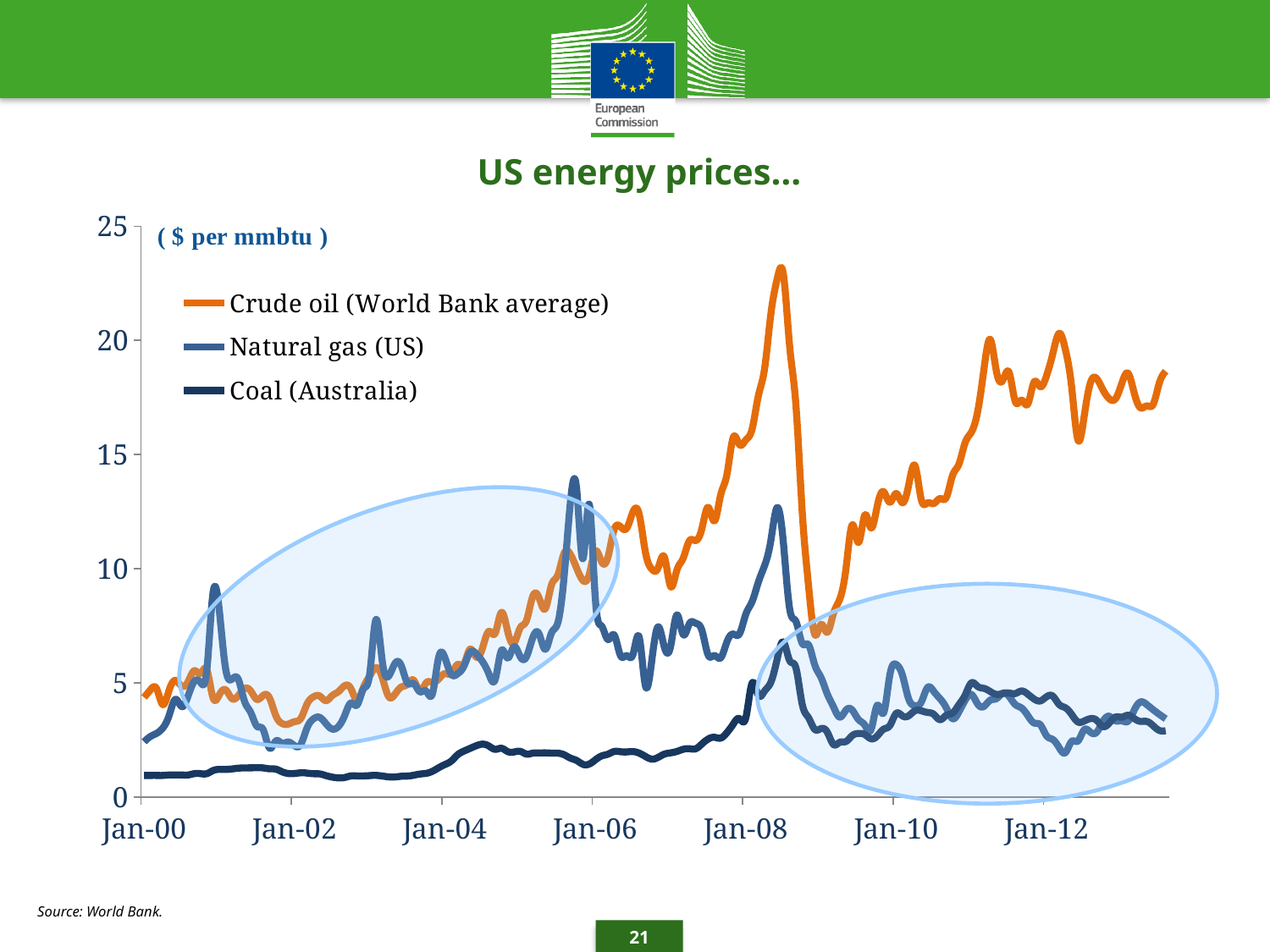
What kind of chart is shown on the slide? Line chart How many series does the legend list? 3 Is the value for Natural gas (US) at Jan-12 greater or less than 10? less Which series has the lowest value at Jan-00? Coal (Australia) Does the Crude oil (World Bank average) series rise or fall between Jan-02 and Jan-08? rise Which series reaches the highest value anywhere on the chart? Crude oil (World Bank average) Is the value for Coal (Australia) at Jan-00 greater or less than 5? less What is the title of the chart? US energy prices… At Jan-06, which is higher: Natural gas (US) or Coal (Australia)? Natural gas (US) At Jan-08, which is higher: Crude oil (World Bank average) or Natural gas (US)? Crude oil (World Bank average) In what unit are the prices on the chart expressed? $ per mmbtu Is the peak value of Crude oil (World Bank average) in 2008 greater or less than 20? greater